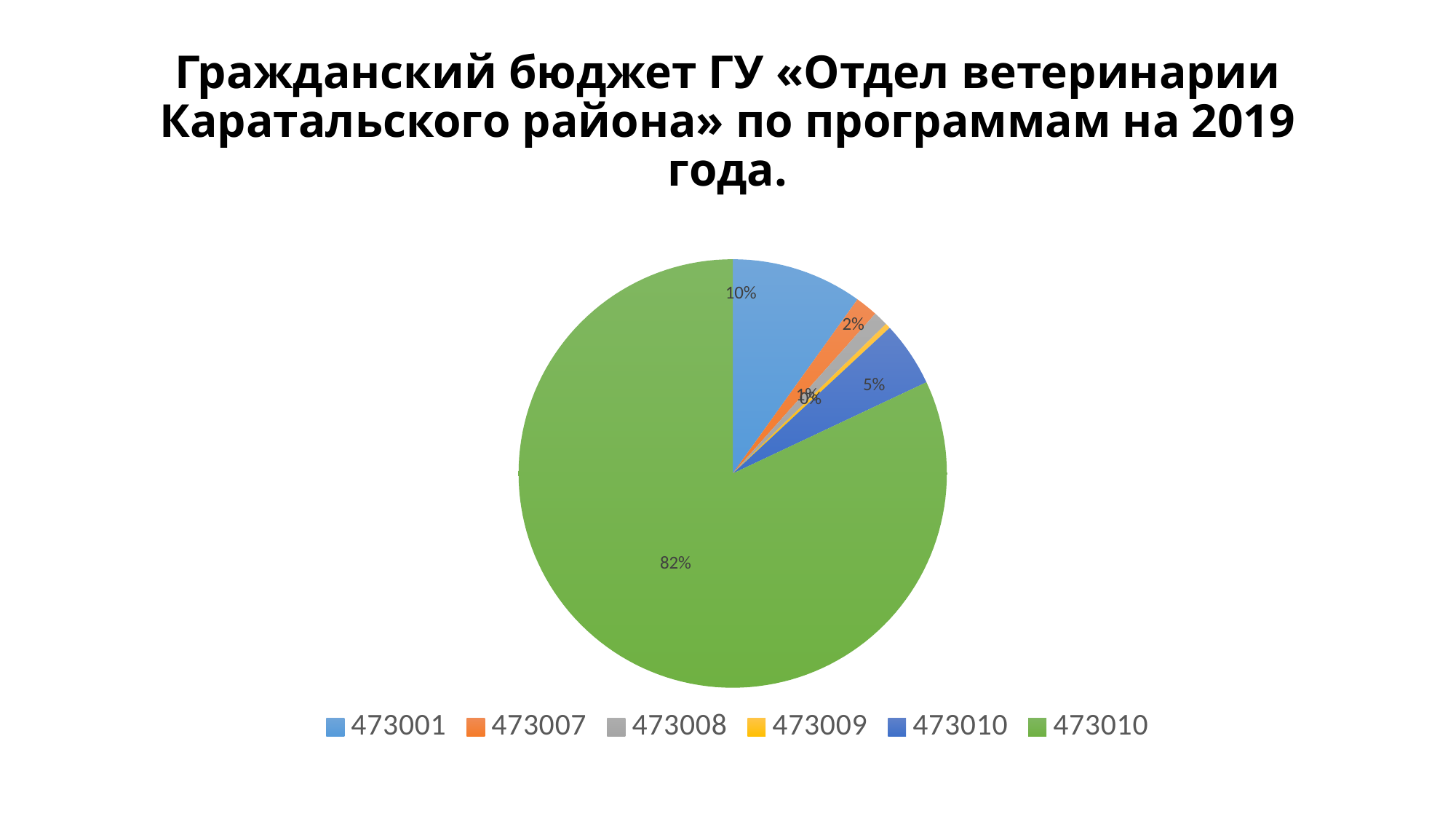
Which is larger, the slice for 473001 or the slice for 473007? 473001 What is the difference in percentage points between the green slice and the dark blue slice? 77% What percentage is shown for the dark blue slice? 5% Which category has the largest slice of the pie? 473010 What is the difference in percentage points between the slice for 473001 and the slice for 473007? 8% What share of the pie does 473001 represent? 10% How many entries does the legend list? 6 How many slices does the pie chart have? 6 Which category has the smallest slice of the pie? 473009 What kind of chart is shown on the slide? pie chart What percentage is shown for the large green slice? 82% What share of the pie does 473007 represent? 2%